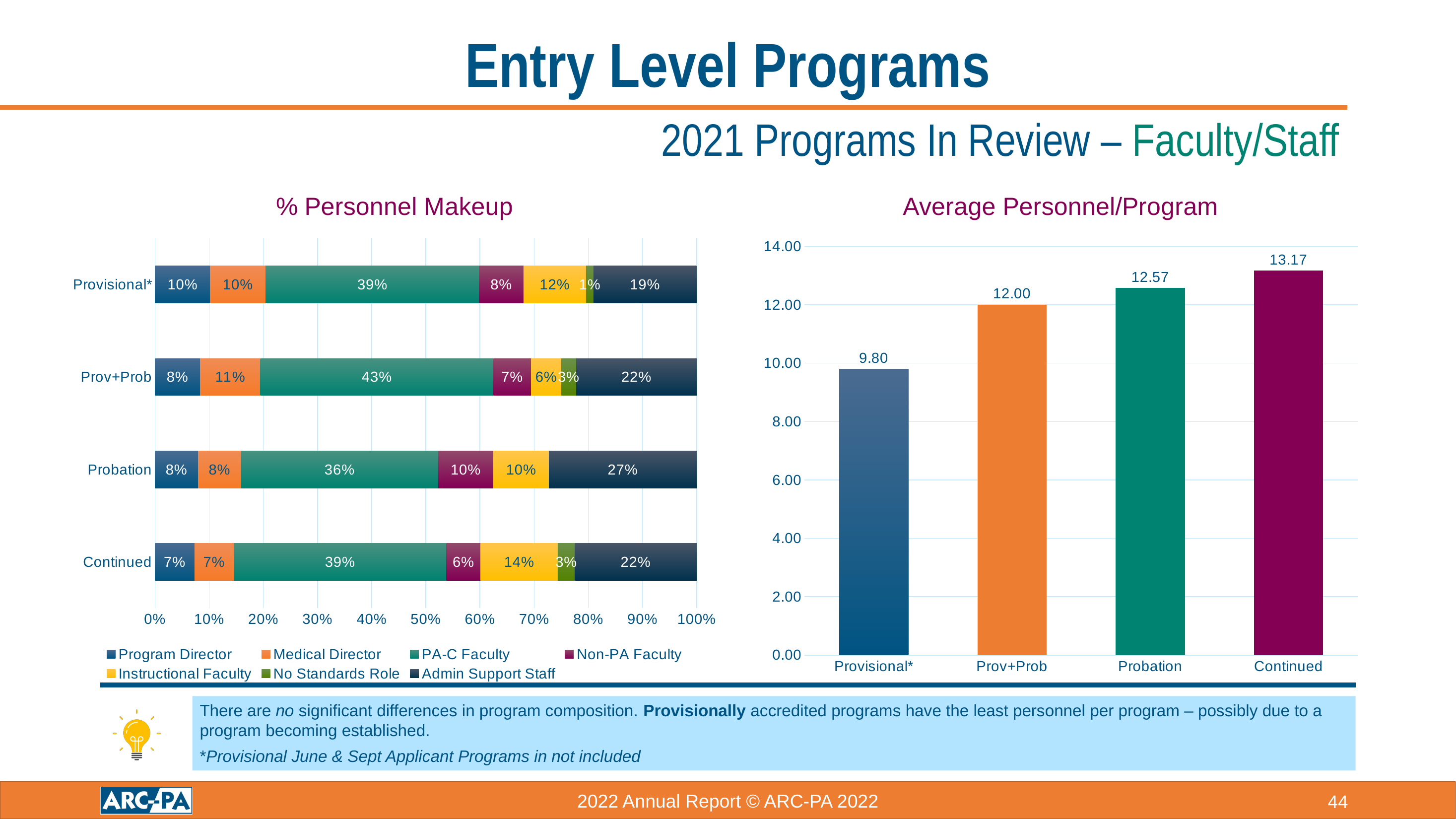
In the Average Personnel/Program chart, how many categories are shown on the x axis? 4 In the Average Personnel/Program chart, do the values rise or fall from Provisional* to Continued? rise In the % Personnel Makeup chart, what is the PA-C Faculty share for Prov+Prob? 43% In the Average Personnel/Program chart, what is the difference between the values for Continued and Provisional*? 3.37 In the % Personnel Makeup chart, which is larger: the Instructional Faculty share for Continued or for Prov+Prob? Continued What kind of chart is the % Personnel Makeup chart? stacked bar chart In the Average Personnel/Program chart, which category has the highest value? Continued In the % Personnel Makeup chart, what is the Admin Support Staff share for Probation? 27% In the Average Personnel/Program chart, which category has the lowest value? Provisional* In the Average Personnel/Program chart, what is the value for Probation? 12.57 How many series does the legend of the % Personnel Makeup chart list? 7 In the % Personnel Makeup chart, what is the difference between the Admin Support Staff share for Probation and for Provisional*? 8%